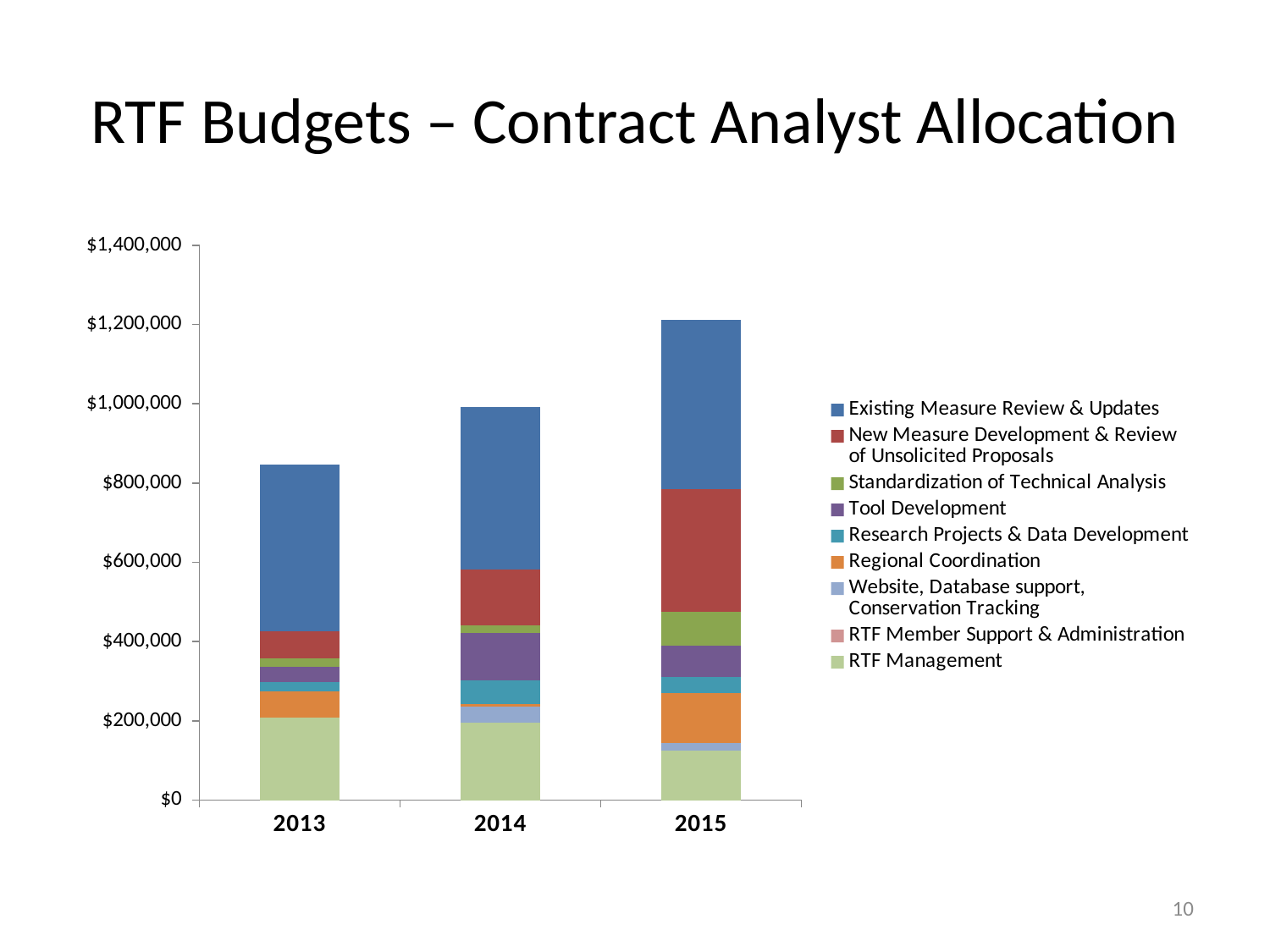
Which year has the highest total contract analyst allocation? 2015 Which total is larger, 2013 or 2015? 2015 Is the total bar for 2013 greater or less than $1,000,000? less Which year has the lowest total contract analyst allocation? 2013 How many series does the chart's legend list? 9 How many years are shown on the x axis of the chart? 3 Is the total bar for 2014 greater or less than $800,000? greater Do the total bar heights rise or fall from 2013 to 2015? Rise What kind of chart is shown on the slide? Stacked bar chart Which series appears as the topmost segment of each stacked bar? Existing Measure Review & Updates Is the total bar for 2015 greater or less than $1,000,000? greater